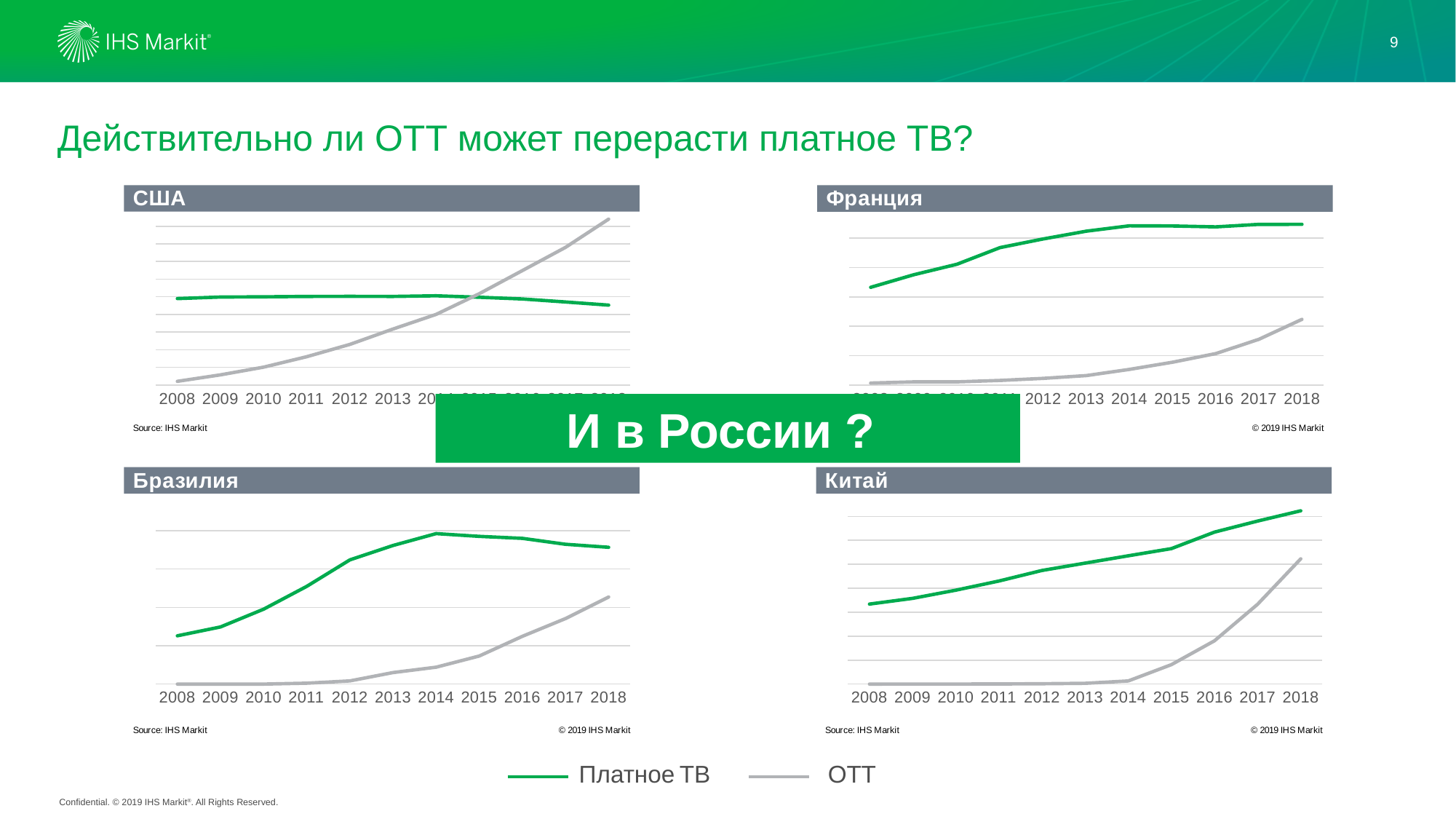
In the "США" chart, which series is higher in 2018, Платное ТВ or OTT? OTT What is the title of the chart in the bottom-right of the slide? Китай In the "Китай" chart, which series is higher in 2014, Платное ТВ or OTT? Платное ТВ In the "Франция" chart, which series is higher in 2018, Платное ТВ or OTT? Платное ТВ In the "США" chart, does the OTT line rise or fall from 2008 to 2018? rises What kind of chart is the "США" chart? line chart Which colour is used for the OTT series in the legend? grey In the "Китай" chart, does the Платное ТВ line rise or fall from 2008 to 2018? rises How many series does the legend at the bottom of the slide list? 2 How many years are shown on the x axis of the "Бразилия" chart? 11